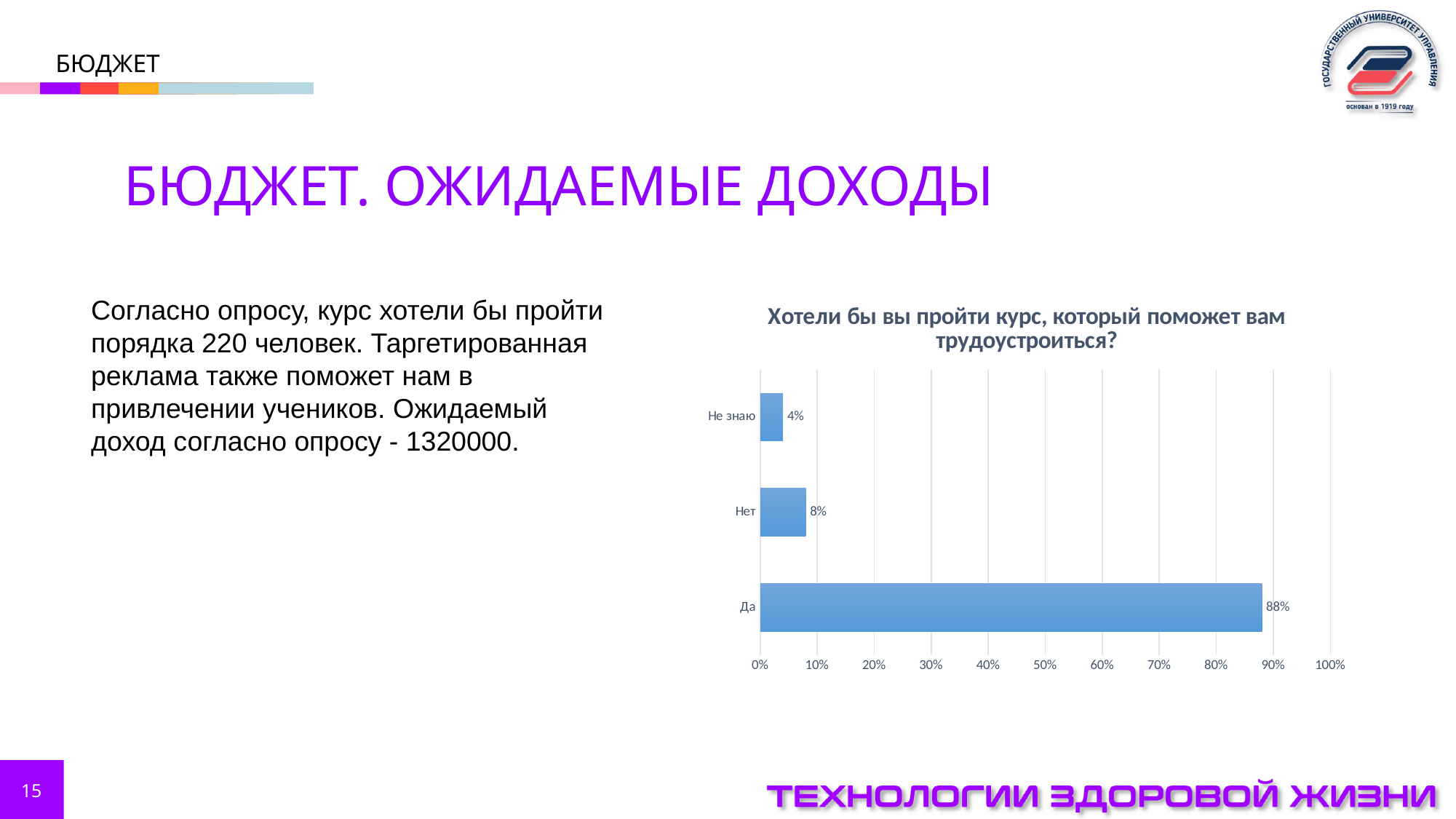
Which category has the highest value? Да What is the difference between the values for "Нет" and "Не знаю"? 4% Which is larger, the value for "Нет" or the value for "Не знаю"? Нет How many categories are shown in the chart? 3 Is the value for "Да" greater or less than 80%? greater What is the title of the chart? Хотели бы вы пройти курс, который поможет вам трудоустроиться? What is the value for "Нет"? 8% What is the value for "Да"? 88% What kind of chart is shown on the slide? bar chart What is the value for "Не знаю"? 4% What is the difference between the values for "Да" and "Нет"? 80% Which category has the lowest value? Не знаю